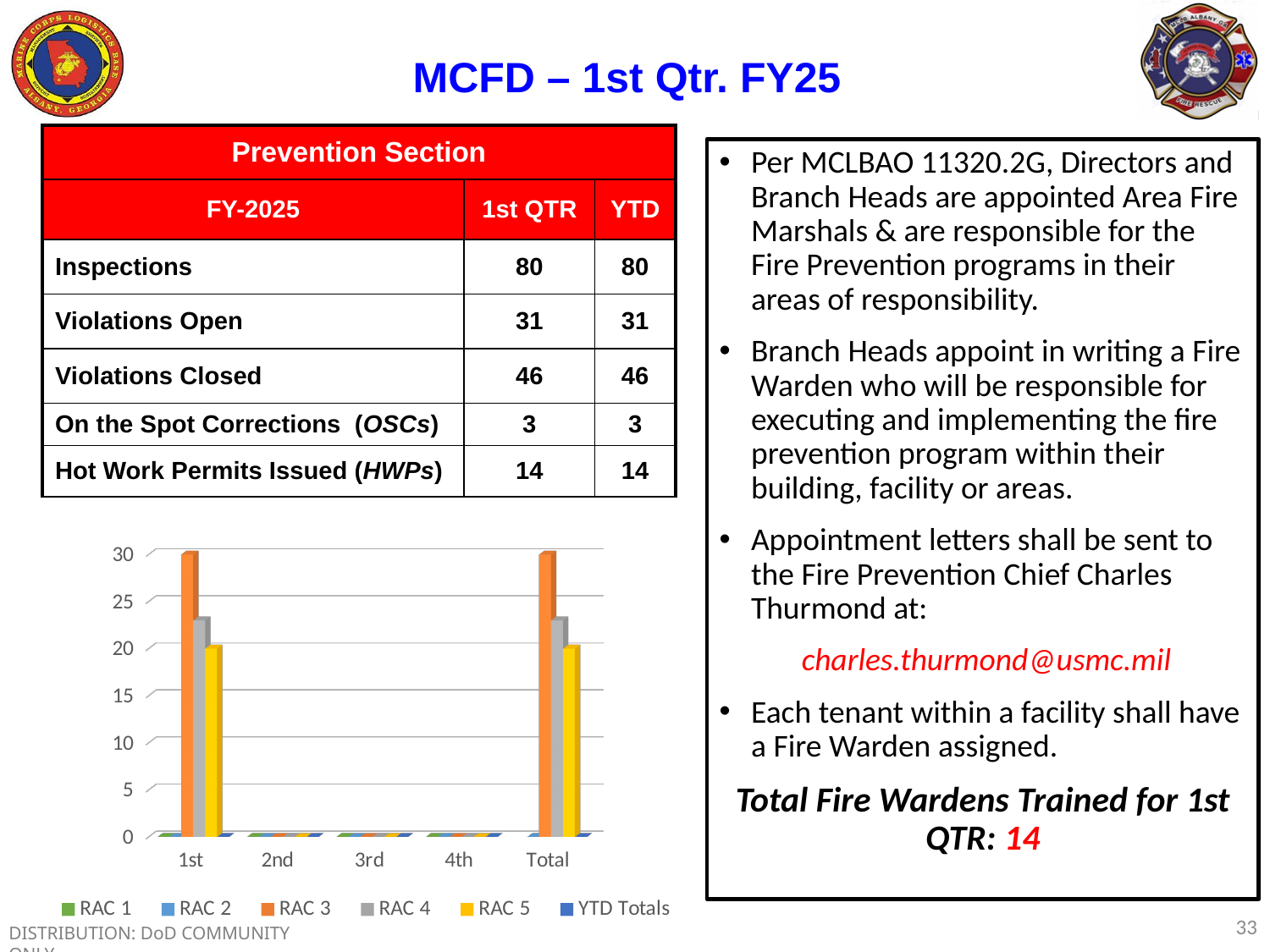
What kind of chart is shown on the slide? bar chart Is the value for RAC 3 in the 1st category greater or less than 25? greater In the 1st category, which is larger, the RAC 4 bar or the RAC 5 bar? RAC 4 Is the value for RAC 5 in the 1st category greater or less than 25? less Is the value for RAC 4 in the Total category greater or less than 15? greater In the 1st category, which is larger, the RAC 3 bar or the RAC 5 bar? RAC 3 How many series does the chart legend list? 6 Which series has the tallest bar in the Total category? RAC 3 What colour is used for the RAC 5 series in the chart legend? yellow Which series has the tallest bar in the 1st category? RAC 3 How many categories are shown along the x axis of the chart? 5